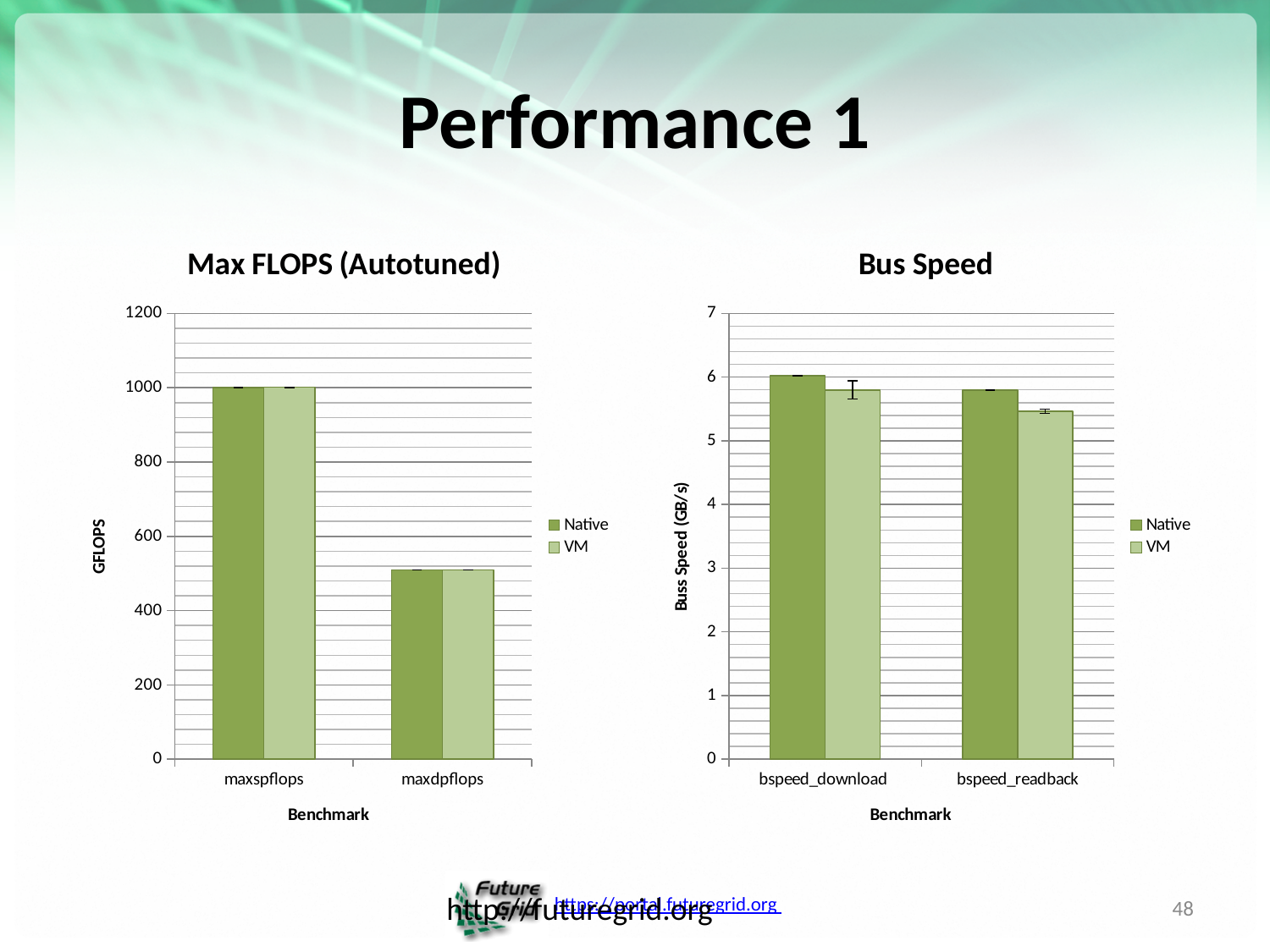
In the Max FLOPS (Autotuned) chart, what type of chart is shown? bar chart In the Bus Speed chart, which bar is the lowest? VM for bspeed_readback In the Max FLOPS (Autotuned) chart, is the Native value for maxspflops greater or less than 800? greater In the Max FLOPS (Autotuned) chart, how many series does the legend list? 2 In the Max FLOPS (Autotuned) chart, how many benchmark categories are shown on the x axis? 2 In the Max FLOPS (Autotuned) chart, is the Native value for maxdpflops greater or less than 600? less In the Bus Speed chart, which is larger: the Native value for bspeed_download or the VM value for bspeed_readback? Native value for bspeed_download In the Max FLOPS (Autotuned) chart, what is the label of the y axis? GFLOPS In the Max FLOPS (Autotuned) chart, which benchmark has the lower Native value? maxdpflops In the Bus Speed chart, what are the two series listed in the legend? Native and VM In the Bus Speed chart, is the Native value for bspeed_download greater or less than 5? greater